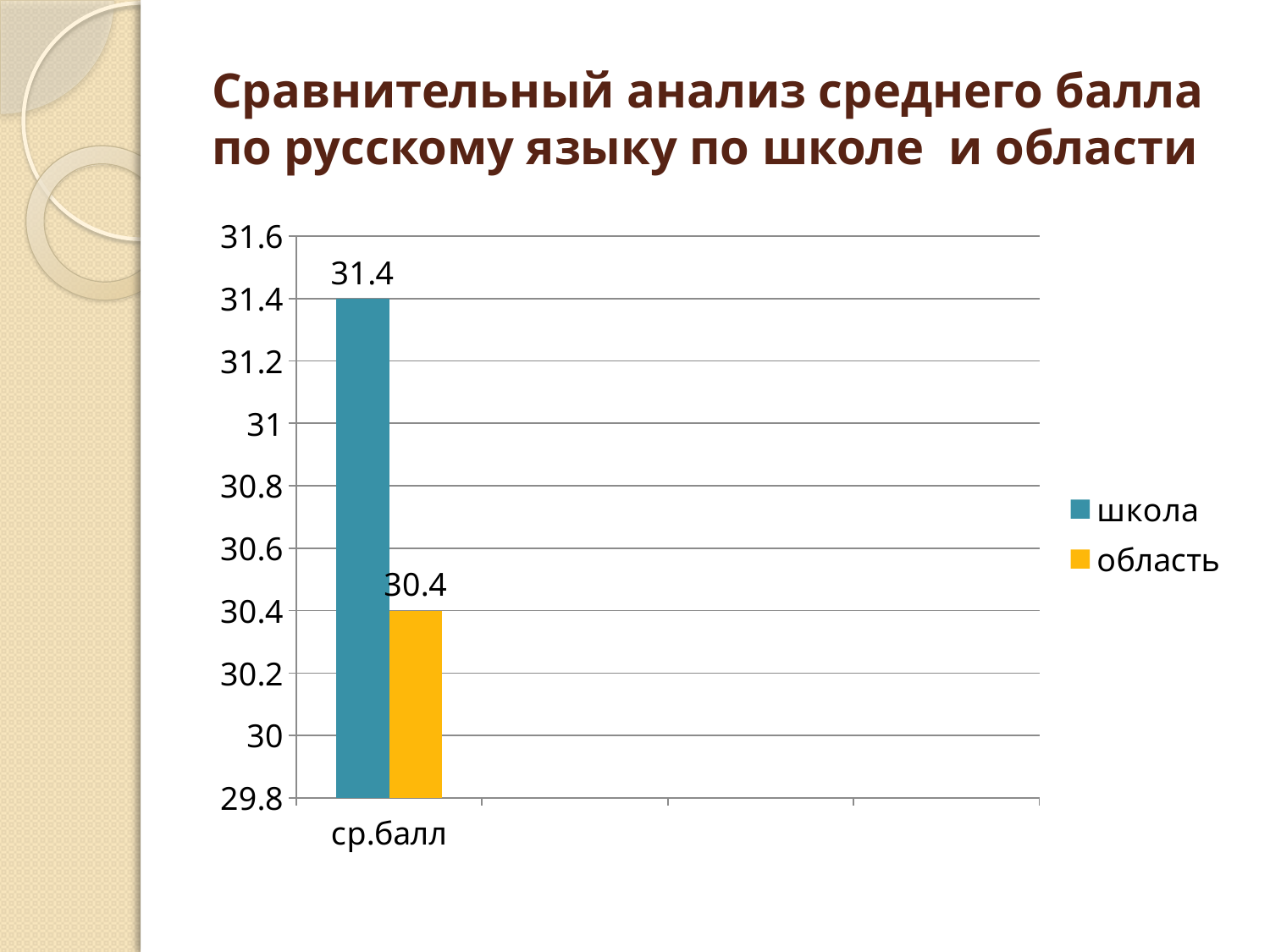
What kind of chart is shown on the slide? bar chart How many categories are shown on the x axis? 1 What is the value for школа in the ср.балл category? 31.4 What is the value for область in the ср.балл category? 30.4 Is the value for школа greater or less than 31? greater How many series does the legend list? 2 What is the label of the category on the x axis? ср.балл Is the value for область greater or less than 31? less Which colour represents the область series in the legend? yellow Which series has the lowest value on the chart? область Which series has the higher value for ср.балл, школа or область? школа What is the difference between the школа and область values for ср.балл? 1